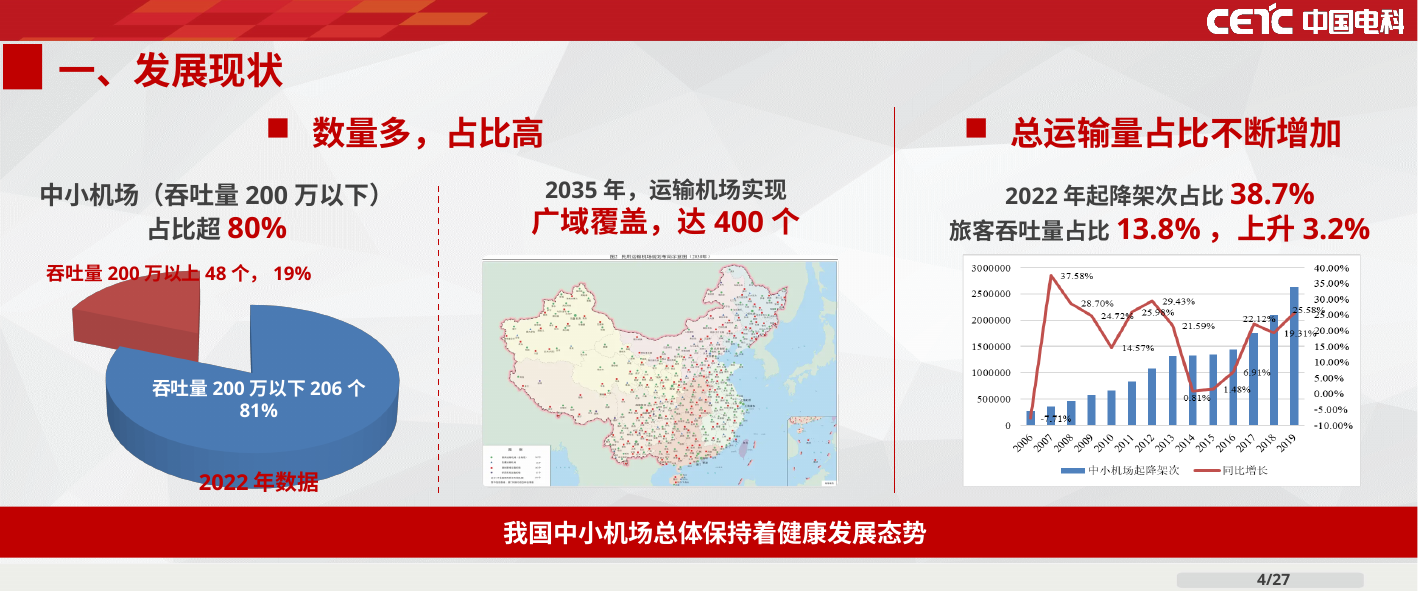
In the chart on the right, is the 中小机场起降架次 bar for 2006 greater or less than 500000? less In the pie chart on the left, how many airports are in the 吞吐量200万以上 category? 48个 In the chart on the right, is the 中小机场起降架次 bar for 2019 greater or less than 2000000? greater In the chart on the right, how many years are shown on the x axis? 14 In the chart on the right, what is the 同比增长 value for 2007? 37.58% In the pie chart on the left, what share of the pie is the slice for 吞吐量200万以下? 81% What kind of chart is the chart on the left of the slide (2022年数据)? pie chart In the chart on the right, what is the difference between the 同比增长 values for 2012 and 2013? 3.45% In the chart on the right, which year has the highest 同比增长 value? 2007 In the chart on the right, how many series does the legend list? 2 How many slices does the pie chart on the left have? 2 In the pie chart on the left, which slice is larger: 吞吐量200万以上 or 吞吐量200万以下? 吞吐量200万以下